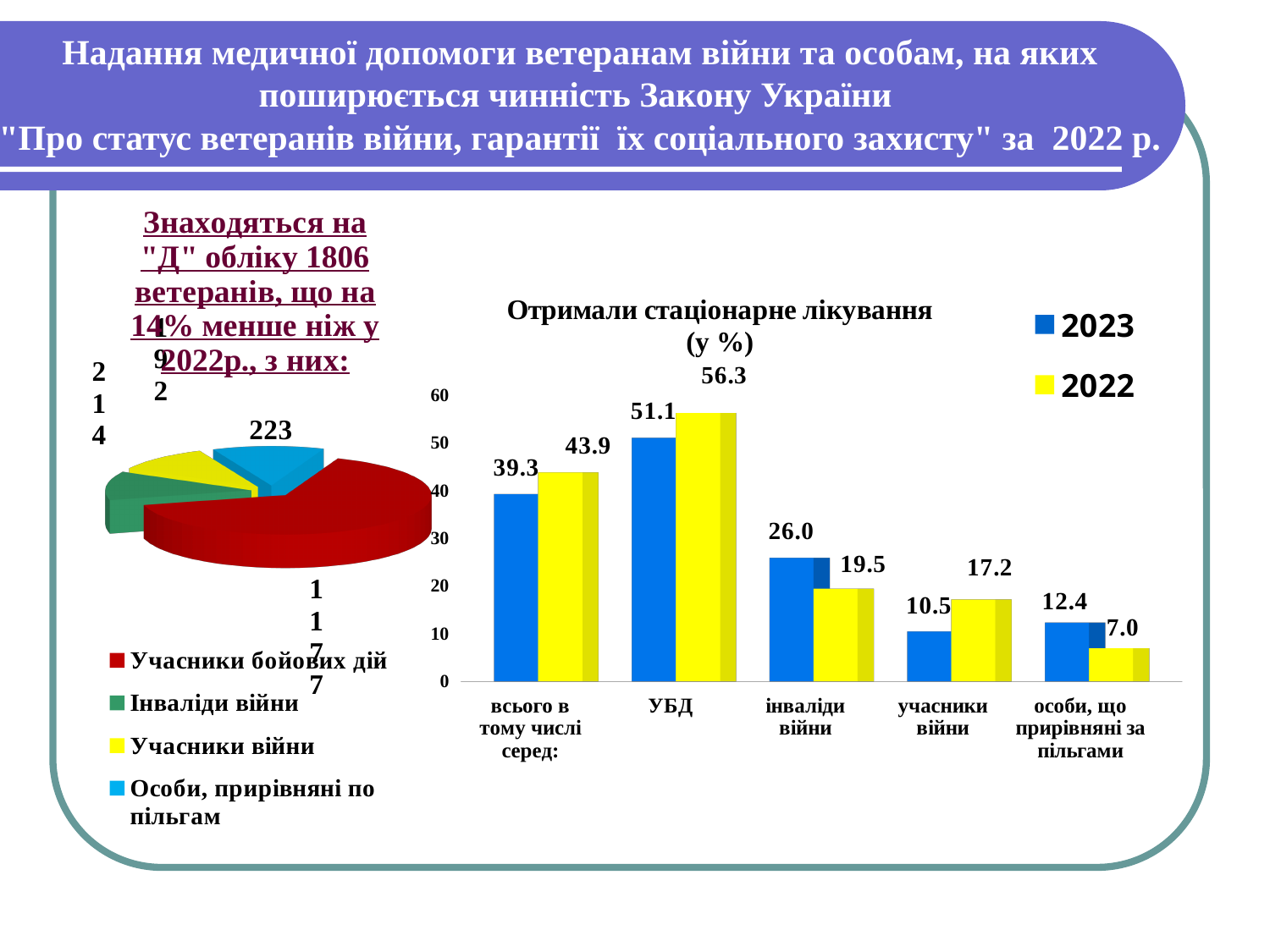
In the bar chart 'Отримали стаціонарне лікування (у %)', what is the 2023 value for УБД? 51.1 In the bar chart 'Отримали стаціонарне лікування (у %)', which is larger for 'інваліди війни': the 2023 value or the 2022 value? 2023 In the bar chart 'Отримали стаціонарне лікування (у %)', what is the 2022 value for 'учасники війни'? 17.2 How many series does the legend of the bar chart 'Отримали стаціонарне лікування (у %)' list? 2 In the bar chart 'Отримали стаціонарне лікування (у %)', which category has the highest 2022 value? УБД In the bar chart 'Отримали стаціонарне лікування (у %)', what is the difference between the 2022 and 2023 values for 'всього в тому числі серед:'? 4.6 In the bar chart 'Отримали стаціонарне лікування (у %)', which category has the lowest 2023 value? учасники війни What kind of chart is the chart on the left of the slide? Pie chart How many categories are shown on the x axis of the bar chart 'Отримали стаціонарне лікування (у %)'? 5 In the bar chart 'Отримали стаціонарне лікування (у %)', what is the 2023 value for 'особи, що прирівняні за пільгами'? 12.4 In the pie chart on the left, what is the value for 'Учасники бойових дій'? 1177 In the pie chart on the left, which category has the largest slice? Учасники бойових дій